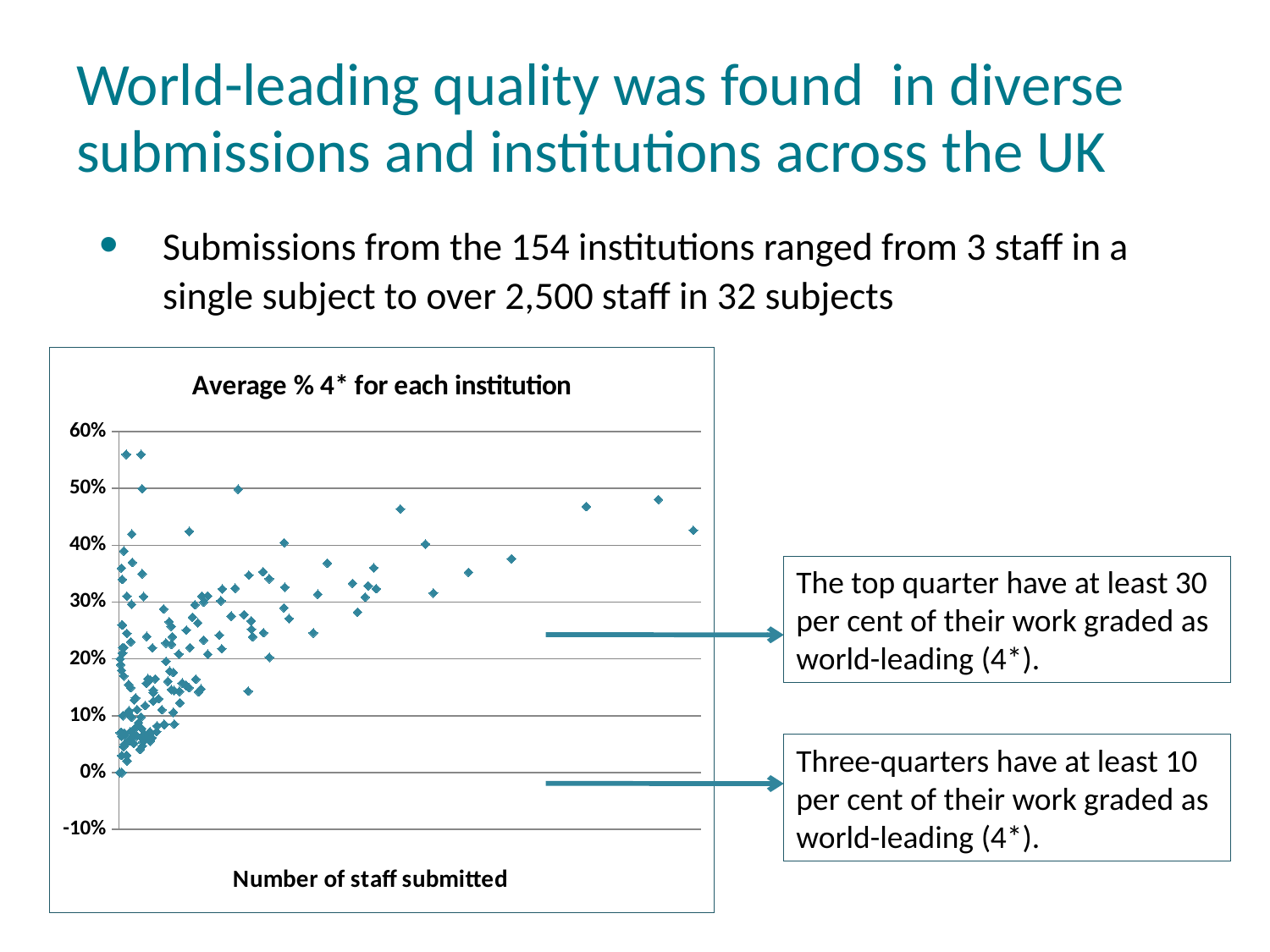
Do the plotted values generally rise or fall as the number of staff submitted increases? rise Is the highest plotted value on the chart greater or less than 50%? greater What is the label on the horizontal axis of the chart? Number of staff submitted What is the title of the chart? Average % 4* for each institution Is the highest plotted value on the chart greater or less than 60%? less Is the lowest plotted value on the chart greater or less than 10%? less What kind of chart is shown on the slide? scatter chart